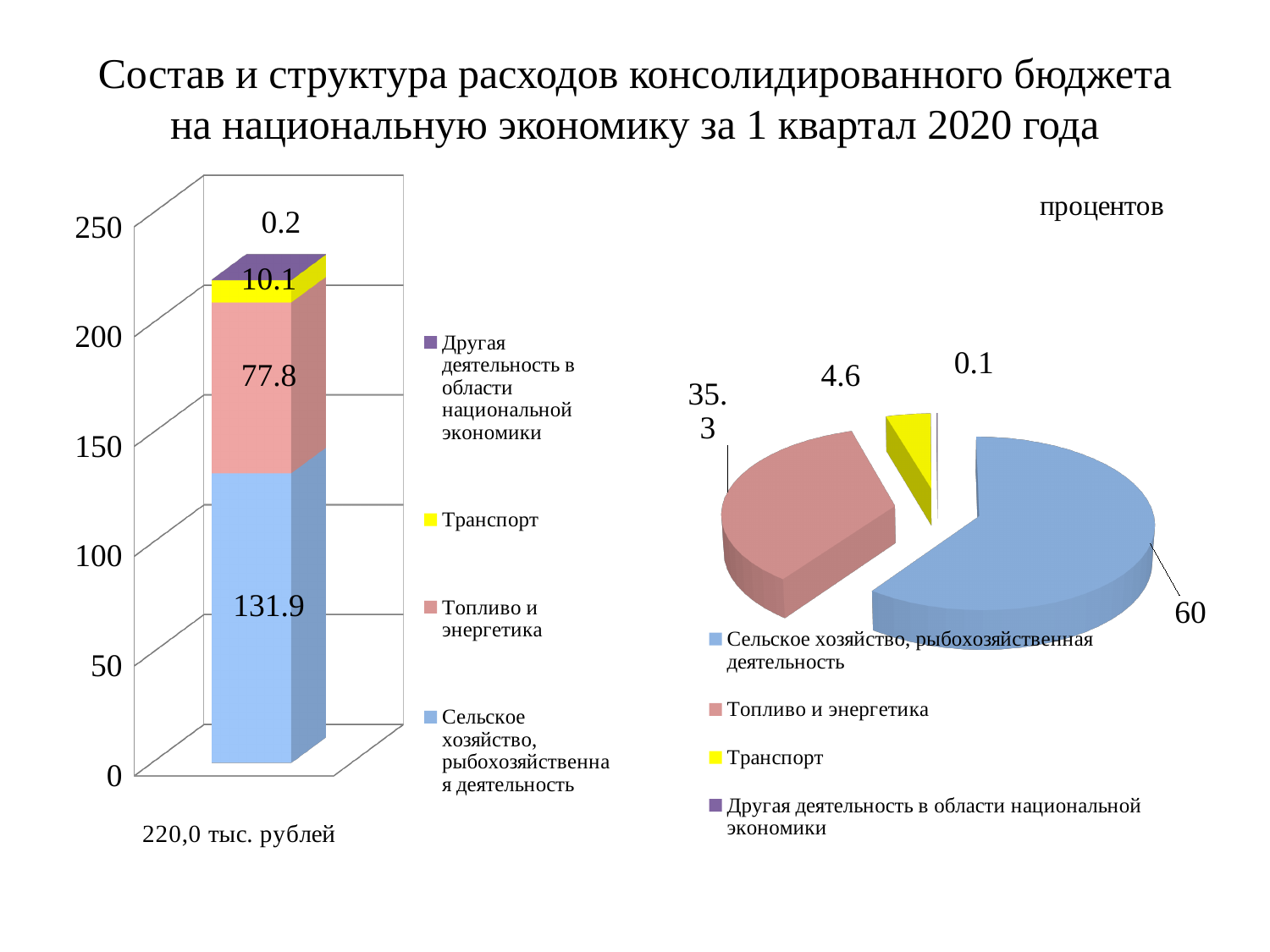
What kind of chart is shown on the right side of the slide? Pie chart In the pie chart on the right, what is the share for Сельское хозяйство, рыбохозяйственная деятельность? 60 In the stacked bar chart on the left, what is the value for Транспорт? 10.1 How many series does the legend of the stacked bar chart on the left list? 4 In the pie chart on the right, which is larger: the share for Транспорт or the share for Топливо и энергетика? Топливо и энергетика In the stacked bar chart on the left, what is the value for Сельское хозяйство, рыбохозяйственная деятельность? 131.9 In the stacked bar chart on the left, what is the value for Другая деятельность в области национальной экономики? 0.2 In the stacked bar chart on the left, what is the total of all segments of the bar? 220.0 In the stacked bar chart on the left, what is the value for Топливо и энергетика? 77.8 In the stacked bar chart on the left, what is the difference between the values for Сельское хозяйство, рыбохозяйственная деятельность and Топливо и энергетика? 54.1 In the pie chart on the right, which category has the smallest share? Другая деятельность в области национальной экономики In the pie chart on the right, what is the share for Топливо и энергетика? 35.3